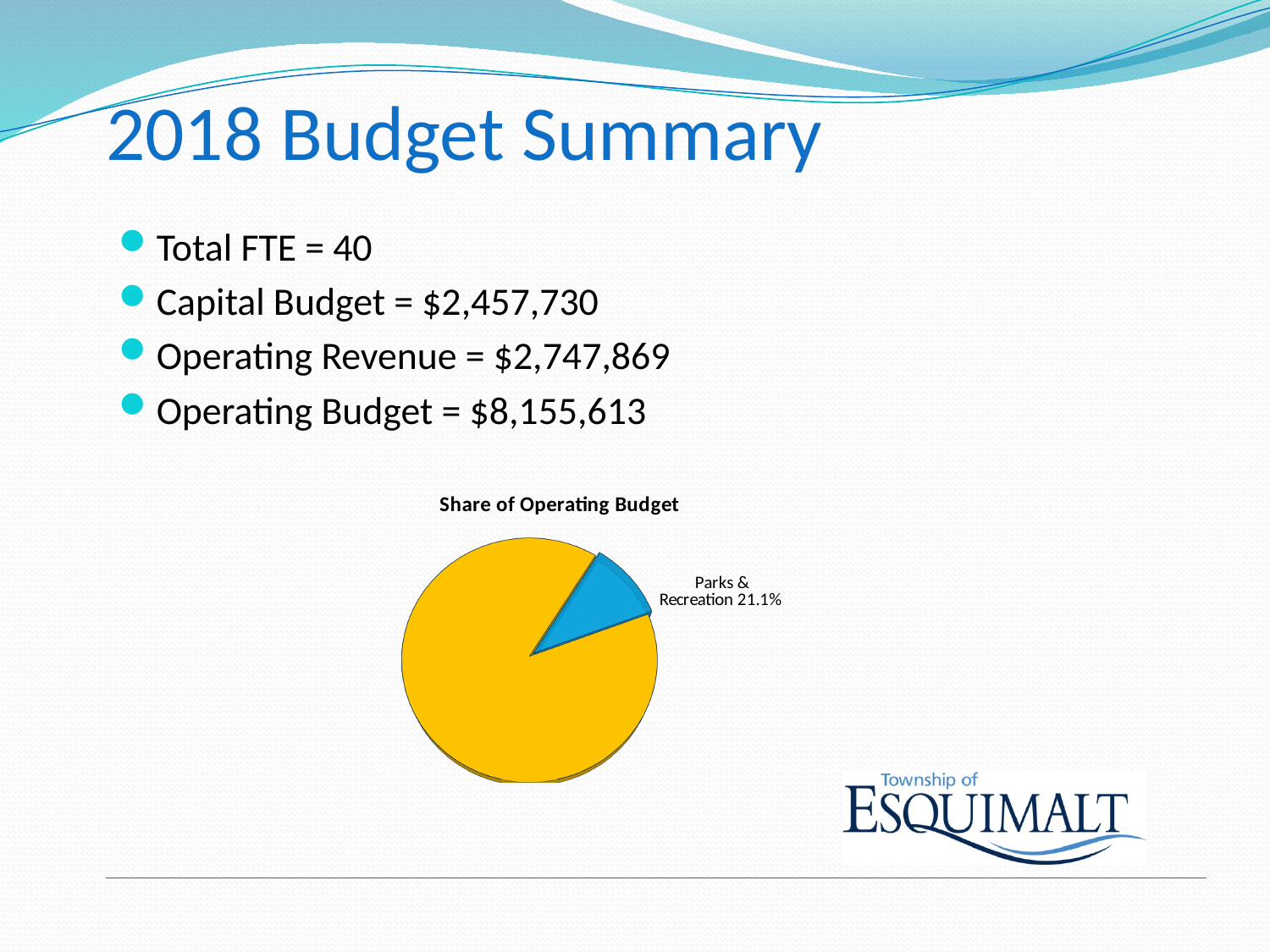
What colour is the Parks & Recreation slice in the pie chart? blue What is the title of the chart on the slide? Share of Operating Budget What kind of chart is shown on the slide? pie chart Which slice of the pie chart is larger, the blue slice or the yellow slice? the yellow slice How many slices does the pie chart have? 2 What share of the operating budget does Parks & Recreation account for in the pie chart? 21.1% Which slice of the pie chart is the smallest? Parks & Recreation Is the Parks & Recreation slice of the pie chart greater or less than half of the pie? less